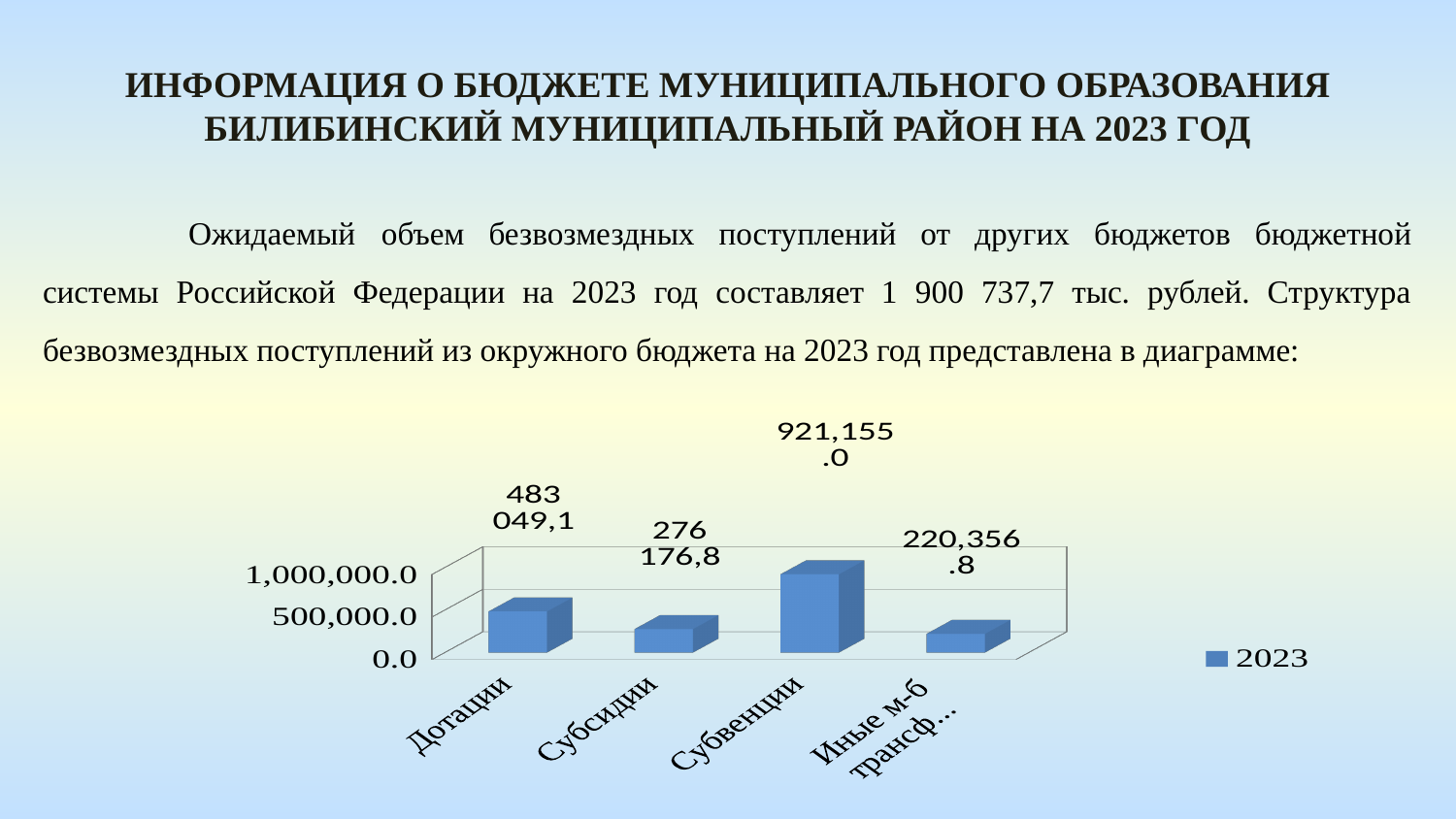
What is the value for Дотации? 483 049,1 What is the difference between the values for Дотации and Субсидии? 206 872,3 How many categories are shown on the chart? 4 What type of chart is shown on the slide? bar chart Which is larger, the value for Дотации or the value for Субсидии? Дотации Which category has the highest value? Субвенции Which category has the lowest value? Иные м-б трансф... What is the value for Субсидии? 276 176,8 What series does the legend list? 2023 What is the value for the rightmost bar (Иные м-б трансф...)? 220,356.8 What is the value for Субвенции? 921,155.0 Is the value for Субвенции greater or less than 500,000.0? greater